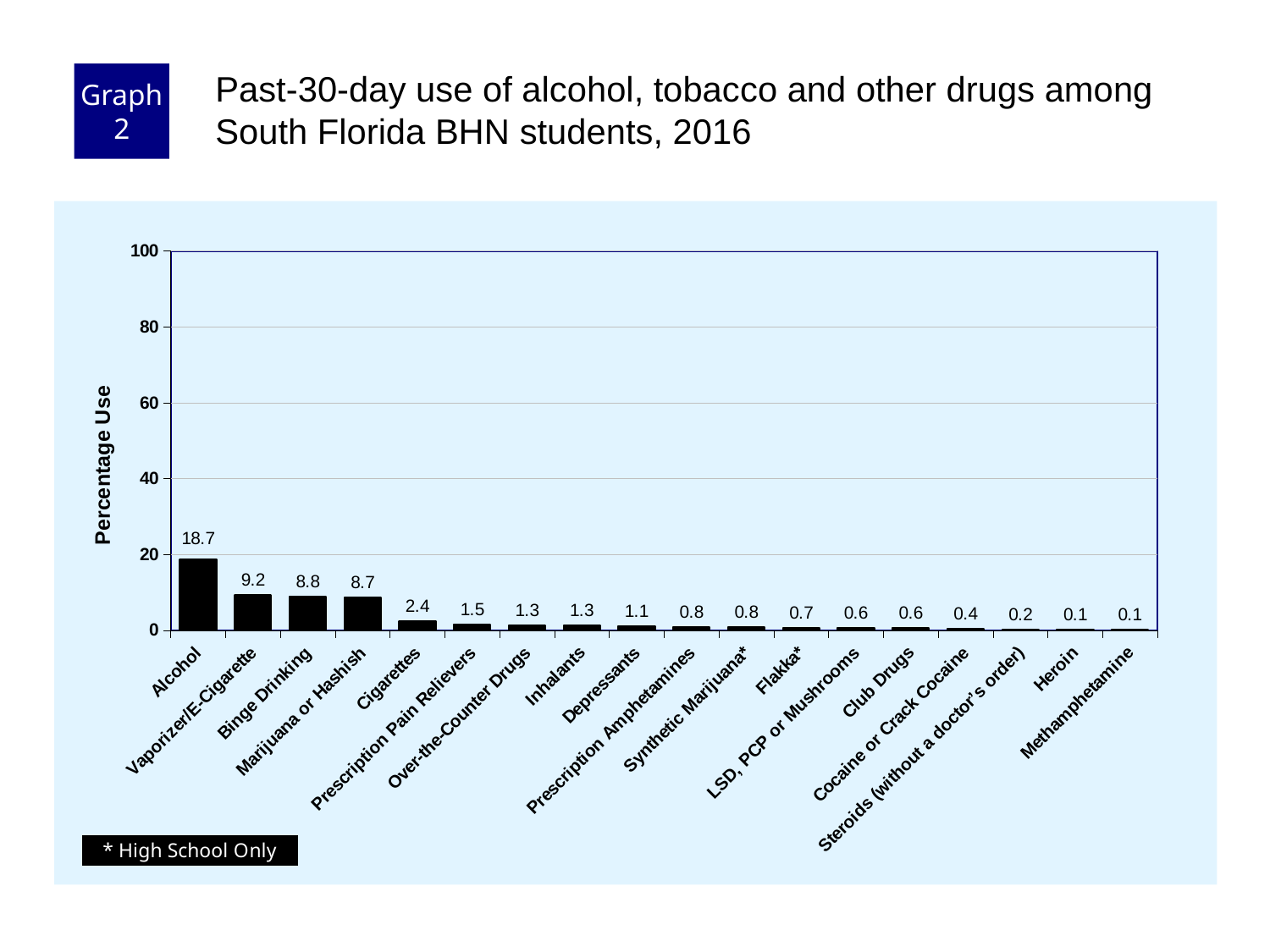
Is the value for Alcohol greater or less than 20? less How many categories are shown on the x axis? 18 What is the label of the y axis? Percentage Use What is the difference in percentage use between Alcohol and Vaporizer/E-Cigarette? 9.5 What is the difference in percentage use between Binge Drinking and Cigarettes? 6.4 What is the percentage use for Alcohol? 18.7 What is the percentage use for Marijuana or Hashish? 8.7 Which has a higher percentage use, Vaporizer/E-Cigarette or Binge Drinking? Vaporizer/E-Cigarette Which category has the highest percentage use? Alcohol What kind of chart is shown on the slide? Bar chart What is the percentage use for Cocaine or Crack Cocaine? 0.4 What is the percentage use for Cigarettes? 2.4